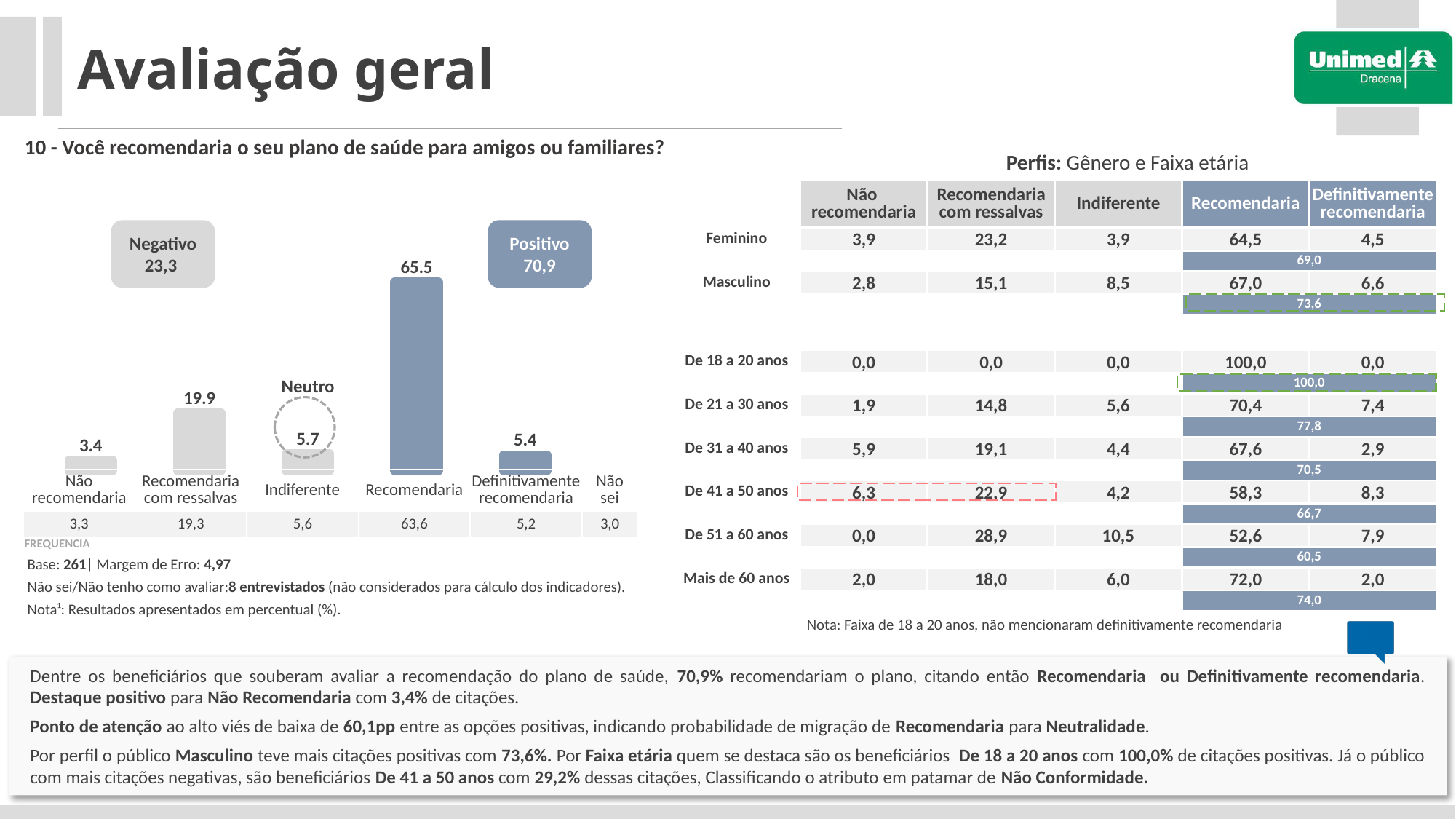
In the bar chart, what value is shown in the dashed circle labelled Neutro? 5.7 In the bar chart, what is the value for Definitivamente recomendaria? 5.4 What type of chart is shown on the left of the slide? bar chart In the bar chart, which category has the lowest value? Não recomendaria In the bar chart, which is larger: Indiferente or Definitivamente recomendaria? Indiferente In the bar chart, what is the value for Recomendaria? 65.5 What value is shown in the box labelled Negativo above the bar chart? 23,3 In the bar chart, what is the difference between Recomendaria and Recomendaria com ressalvas? 45.6 What value is shown in the box labelled Positivo above the bar chart? 70,9 In the bar chart, which category has the highest value? Recomendaria In the bar chart, what is the value for Recomendaria com ressalvas? 19.9 In the bar chart, what is the value for Não recomendaria? 3.4